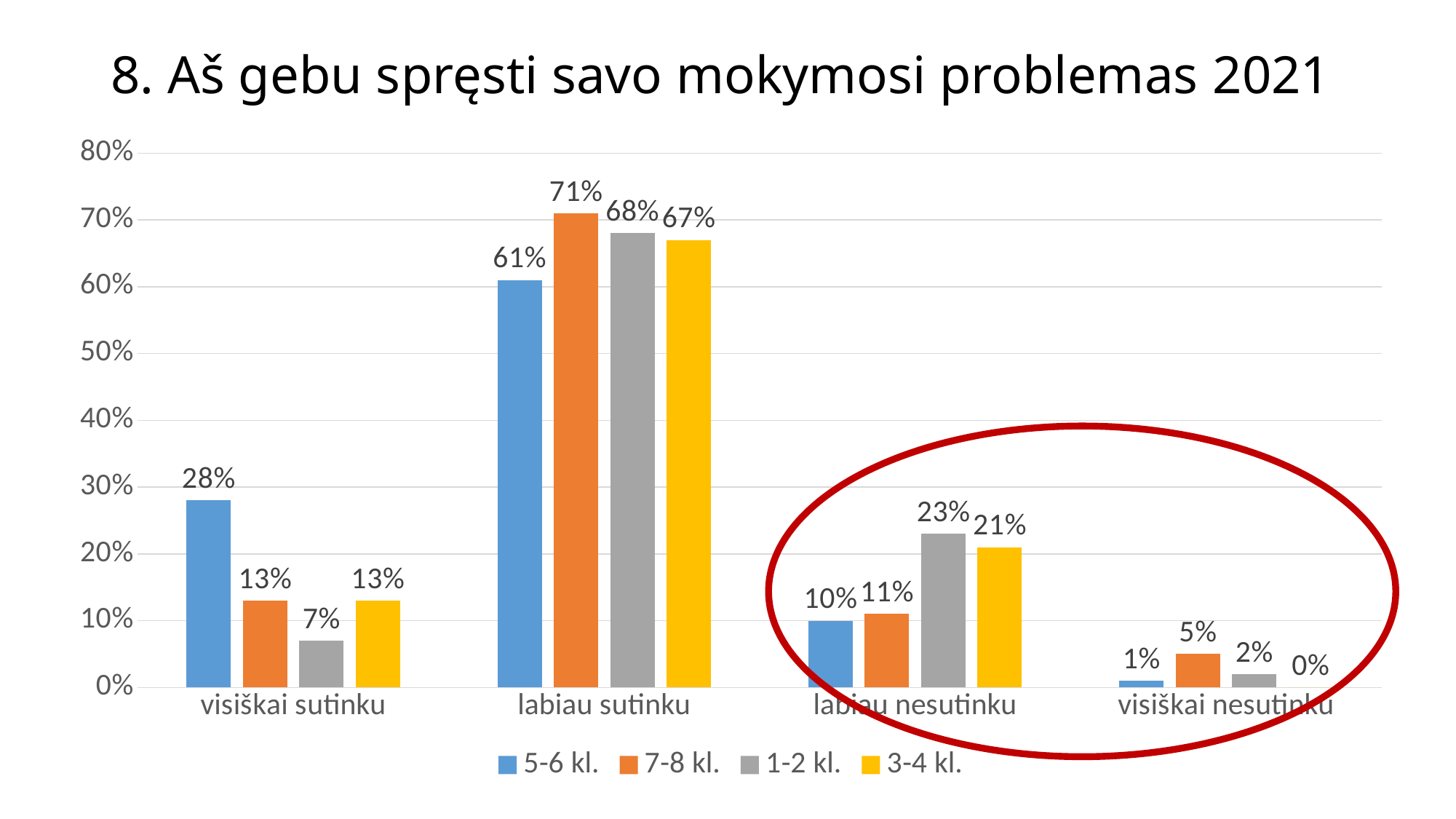
How many categories are shown on the x axis? 4 What is the difference between the 7-8 kl. and 5-6 kl. values in the 'labiau sutinku' category? 10% What is the value for 3-4 kl. in the 'visiškai nesutinku' category? 0% What is the value for 5-6 kl. in the 'visiškai sutinku' category? 28% What is the value for 1-2 kl. in the 'labiau nesutinku' category? 23% What kind of chart is shown on the slide? Bar chart What is the title of the chart? 8. Aš gebu spręsti savo mokymosi problemas 2021 Which series has the highest value in the 'labiau sutinku' category? 7-8 kl. Which is larger in the 'labiau nesutinku' category: the value for 5-6 kl. or the value for 3-4 kl.? 3-4 kl. What is the value for 7-8 kl. in the 'labiau sutinku' category? 71% Which series has the lowest value in the 'visiškai sutinku' category? 1-2 kl. How many series does the legend list? 4